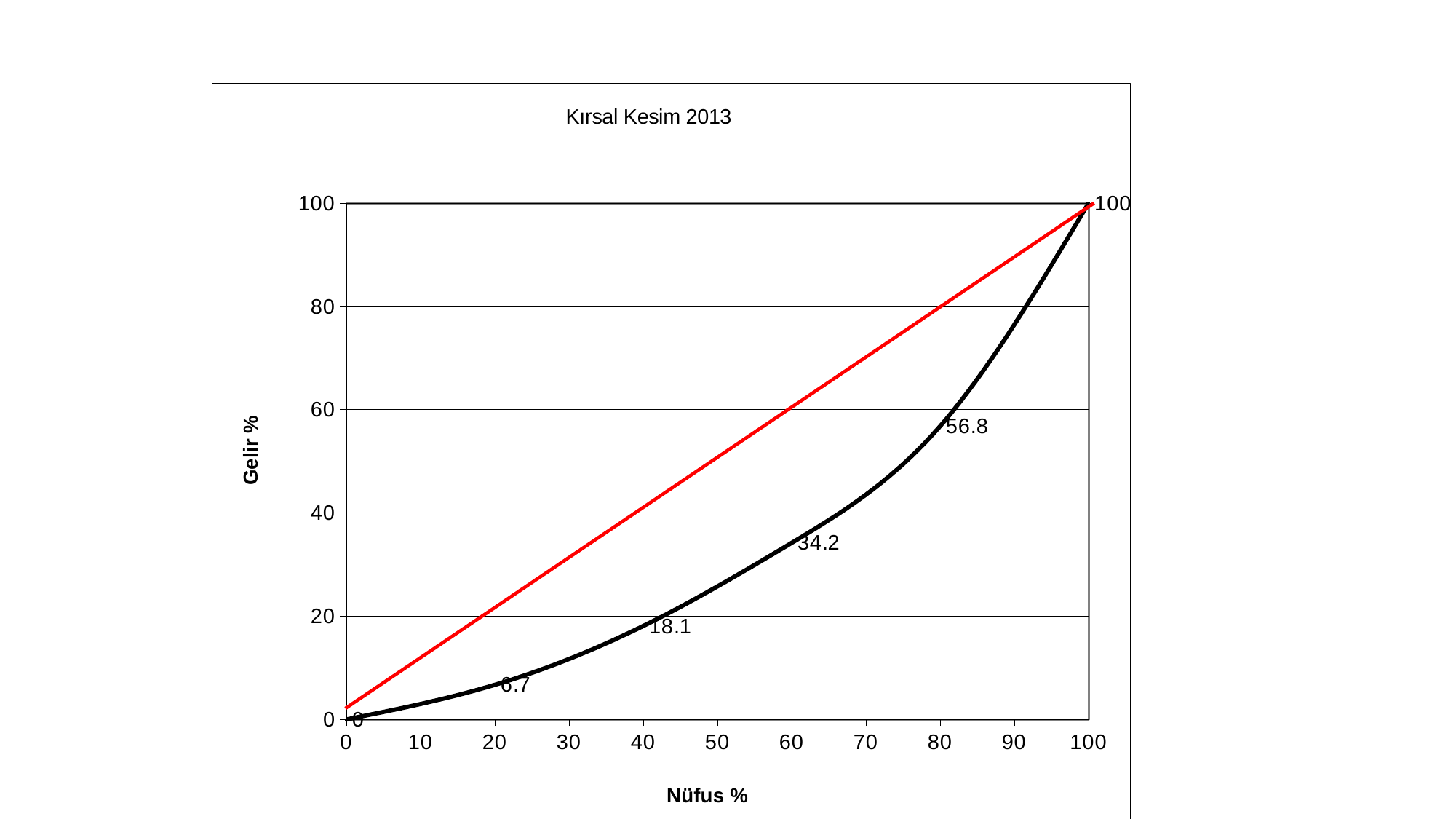
What is the difference between the Gelir % values at Nüfus % 80 and Nüfus % 60 on the black curve? 22.6 What is the Gelir % value of the black curve at Nüfus % 100? 100 Which is larger on the black curve: the value at Nüfus % 40 or at Nüfus % 60? Nüfus % 60 What is the title of the chart? Kırsal Kesim 2013 How many data points are labelled on the black curve? 6 What is the Gelir % value of the black curve at Nüfus % 40? 18.1 What is the Gelir % value of the black curve at Nüfus % 20? 6.7 What kind of chart is shown on the slide? line chart What is the label of the vertical axis? Gelir % What is the Gelir % value of the black curve at Nüfus % 80? 56.8 What is the Gelir % value of the black curve at Nüfus % 60? 34.2 Do the values of the black curve rise or fall as Nüfus % increases? rise